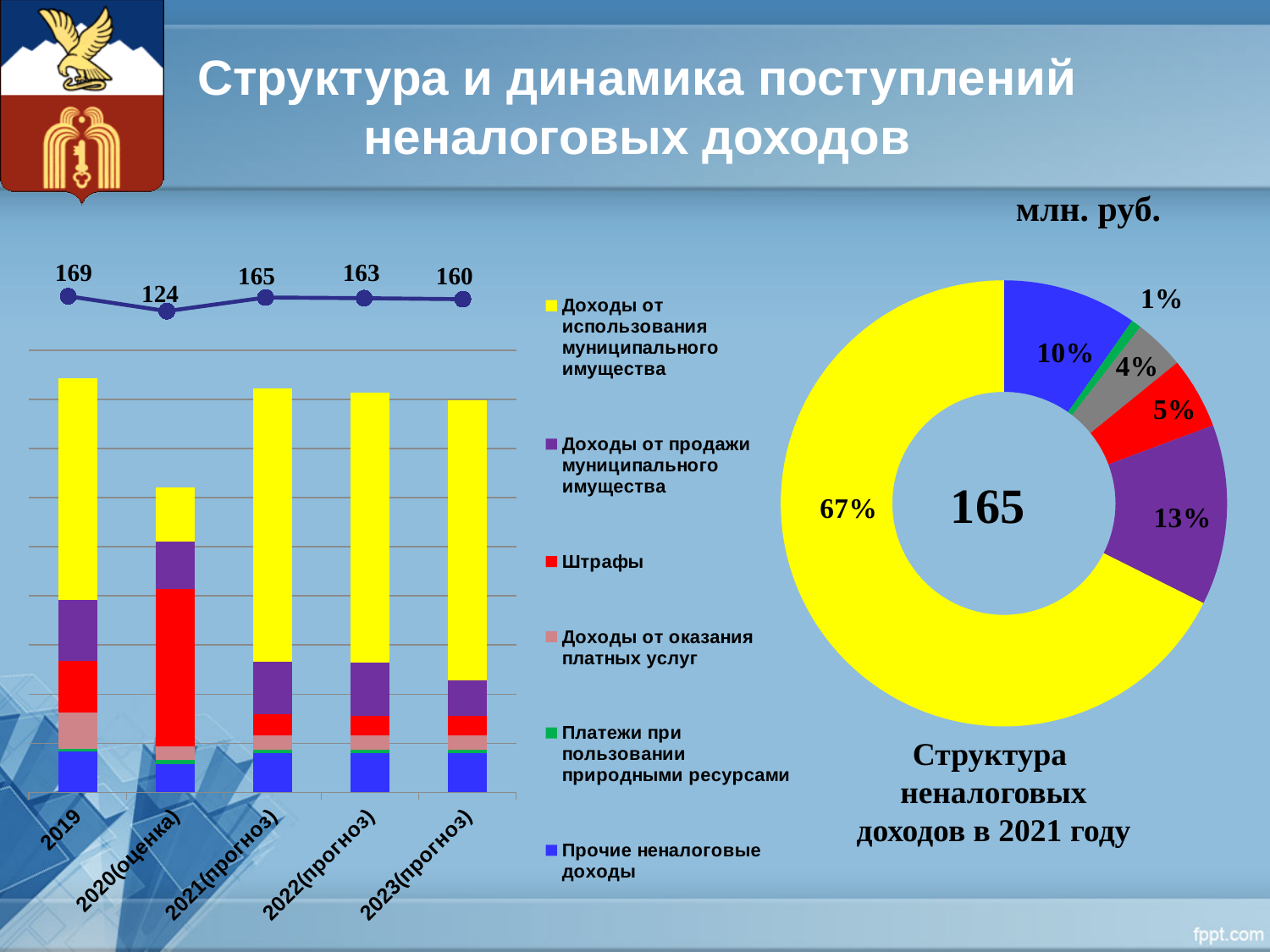
What kind of chart is the left chart? Stacked bar chart with a line On the left chart, what is the difference between the total for 2019 and the total for 2020(оценка)? 45 How many series does the legend list? 6 On the left chart, what is the total value shown for 2019? 169 On the left chart, what is the total value shown for 2020(оценка)? 124 On the right chart 'Структура неналоговых доходов в 2021 году', what number is printed in the centre of the donut? 165 On the left chart, how many years are shown on the x axis? 5 On the right chart 'Структура неналоговых доходов в 2021 году', what share does the yellow slice (Доходы от использования муниципального имущества) have? 67% On the left chart, is the total for 2022(прогноз) larger or smaller than the total for 2023(прогноз)? larger On the left chart, which year has the highest total value on the line? 2019 On the right chart 'Структура неналоговых доходов в 2021 году', what share does the purple slice (Доходы от продажи муниципального имущества) have? 13% On the left chart, which year has the lowest total value on the line? 2020(оценка)